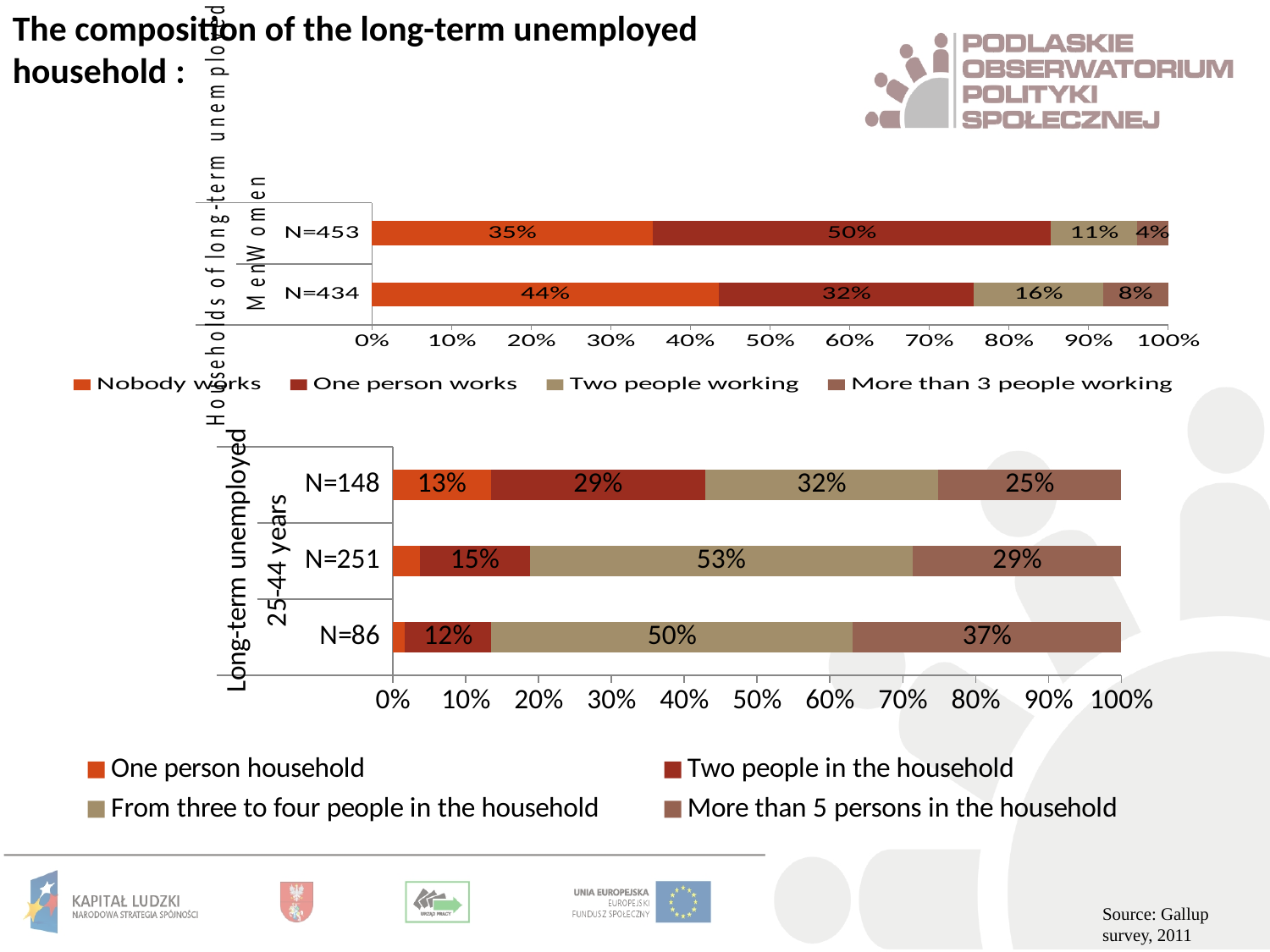
In the bottom chart, what is the value for 'One person household' for the N=148 bar? 13% In the top chart, which bar has the larger 'Two people working' value, N=453 or N=434? N=434 In the bottom chart, which bar has the highest 'More than 5 persons in the household' value? N=86 In the bottom chart, what is the value for 'From three to four people in the household' for the N=251 bar? 53% In the top chart, what is the value for 'One person works' for the N=434 bar? 32% How many series does the legend of the top chart list? 4 In the top chart, what percentage of the N=453 households have nobody working? 35% How many bars (categories) are shown in the bottom chart? 3 What type of chart is the bottom chart? Stacked bar chart In the bottom chart, what is the value for 'More than 5 persons in the household' for the N=86 bar? 37% In the top chart, what is the value for 'More than 3 people working' for the N=453 bar? 4% In the top chart, what is the difference between the 'Nobody works' values for N=434 and N=453? 9%